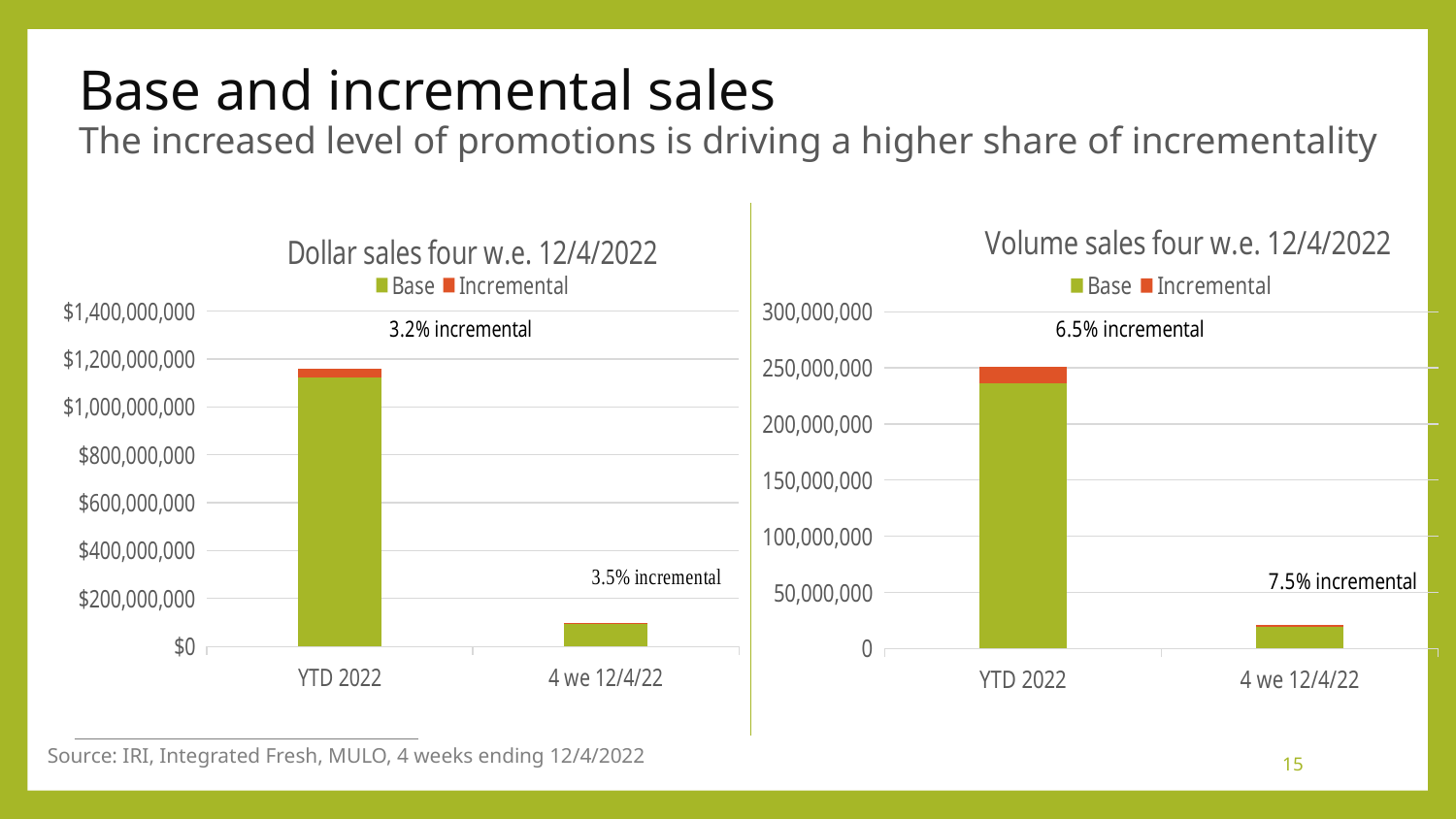
In the Volume sales four w.e. 12/4/2022 chart, which category has the taller bar, YTD 2022 or 4 we 12/4/22? YTD 2022 How many categories are shown on the x axis of the Dollar sales four w.e. 12/4/2022 chart? 2 In the Volume sales four w.e. 12/4/2022 chart, what incremental share is labelled for 4 we 12/4/22? 7.5% incremental In the Volume sales four w.e. 12/4/2022 chart, is the total bar for YTD 2022 greater or less than 200,000,000? greater In the Dollar sales four w.e. 12/4/2022 chart, what incremental share is labelled for YTD 2022? 3.2% incremental In the Dollar sales four w.e. 12/4/2022 chart, is the total bar for 4 we 12/4/22 greater or less than $200,000,000? less In the Dollar sales four w.e. 12/4/2022 chart, what incremental share is labelled for 4 we 12/4/22? 3.5% incremental What kind of chart is the Dollar sales four w.e. 12/4/2022 chart? Stacked bar chart In the Volume sales four w.e. 12/4/2022 chart, what incremental share is labelled for YTD 2022? 6.5% incremental How many series does the legend of the Volume sales four w.e. 12/4/2022 chart list? 2 In the Volume sales four w.e. 12/4/2022 chart, is the total bar for 4 we 12/4/22 greater or less than 50,000,000? less